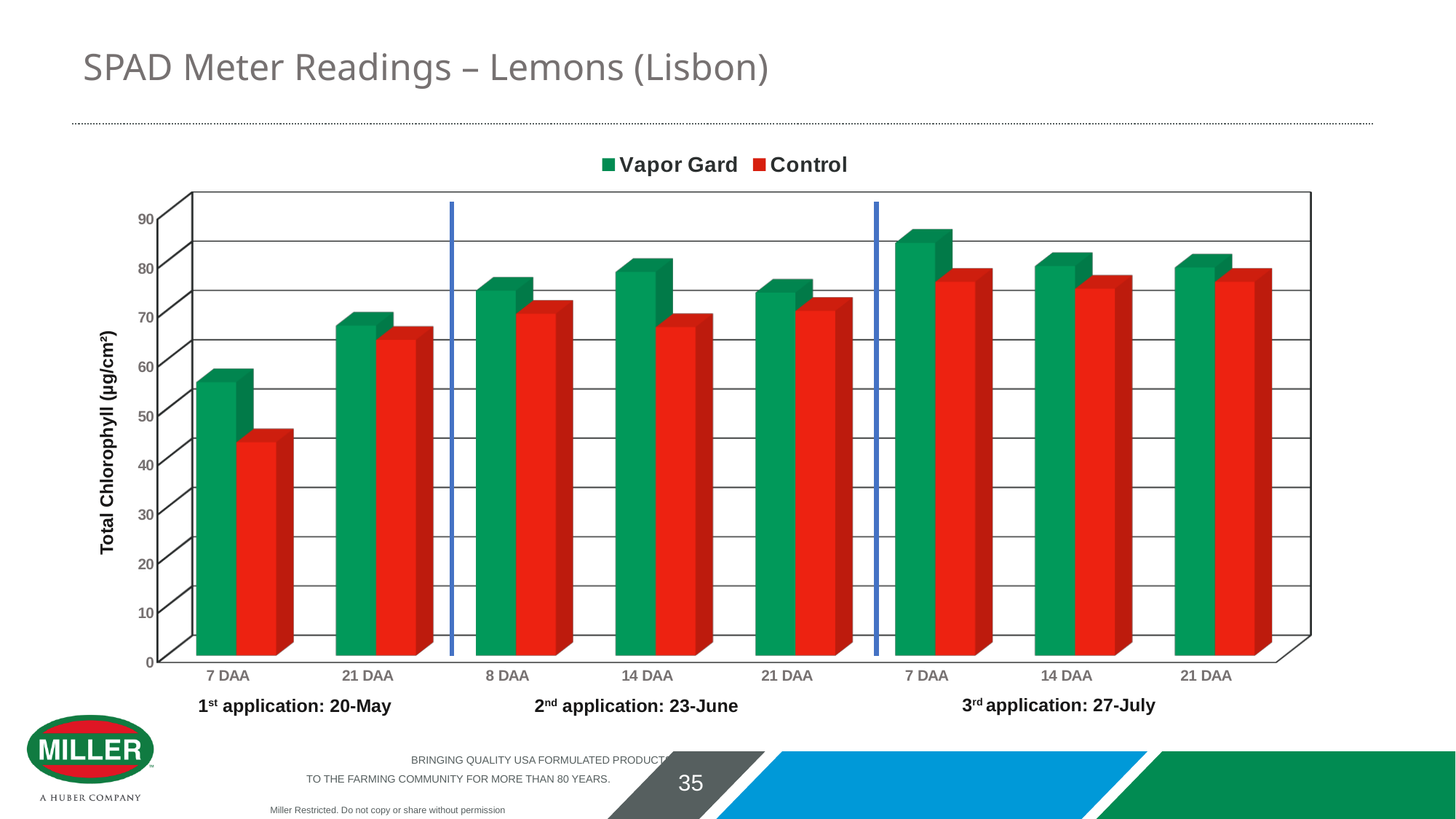
Is the Control value at 14 DAA of the 2nd application (23-June) greater or less than 70? less What kind of chart is shown on the slide? Bar chart At 7 DAA of the 1st application (20-May), which is larger, Vapor Gard or Control? Vapor Gard Is the Vapor Gard value at 7 DAA of the 1st application (20-May) greater or less than 60? less How many series does the legend list? 2 How many DAA categories are plotted along the x axis? 8 Which series is shown in green in the legend? Vapor Gard Is the Vapor Gard value at 7 DAA of the 3rd application (27-July) greater or less than 80? greater What is the label of the vertical axis? Total Chlorophyll (µg/cm²) Which category has the lowest Control value? 7 DAA of the 1st application (20-May) Which category has the highest Vapor Gard value? 7 DAA of the 3rd application (27-July)